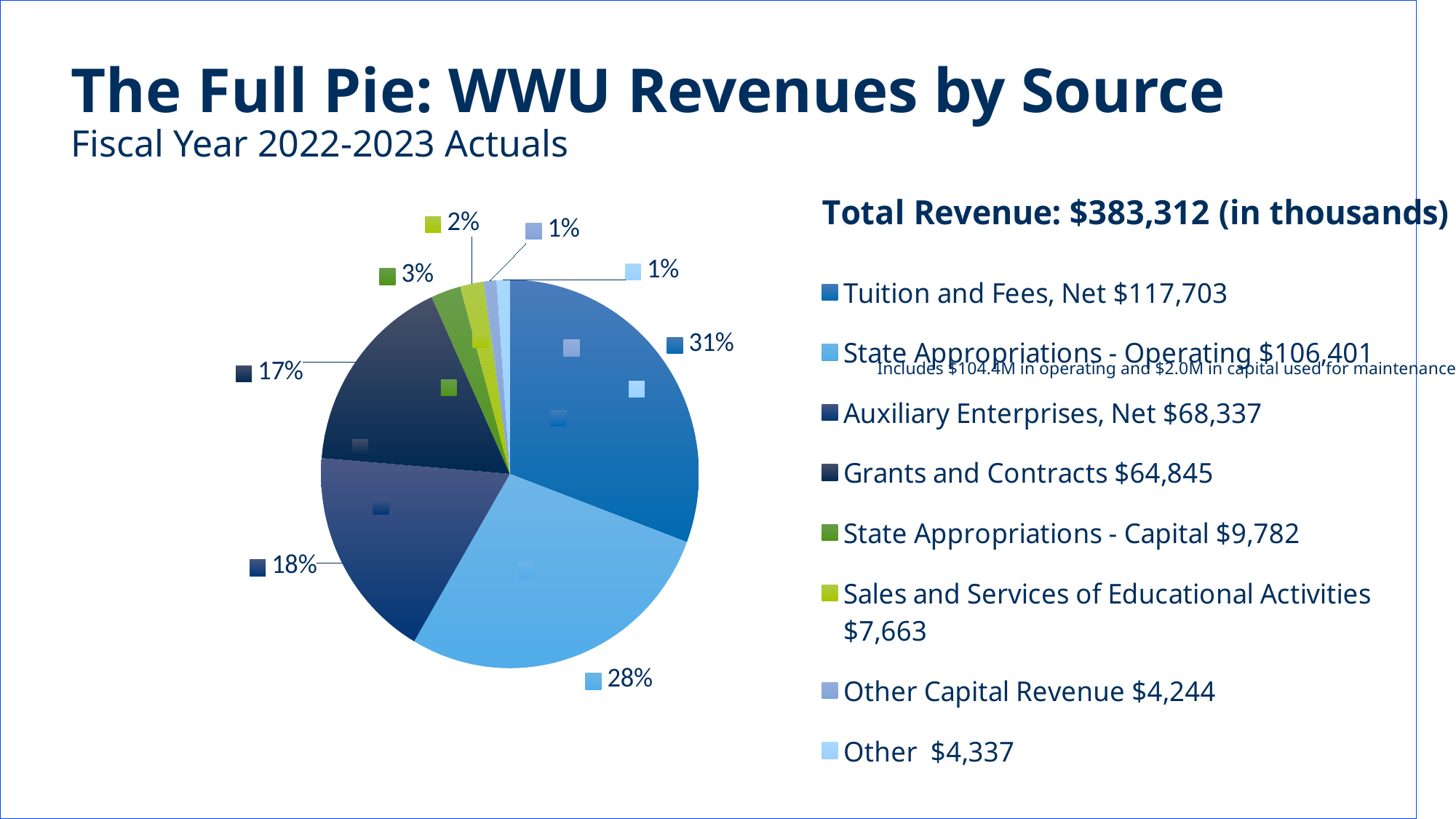
What share of the pie does Tuition and Fees, Net represent? 31% Which is larger, Auxiliary Enterprises, Net or Grants and Contracts? Auxiliary Enterprises, Net What is the revenue value listed for Grants and Contracts? $64,845 Which revenue source has the smallest dollar value listed in the legend? Other Capital Revenue What is the difference between the Tuition and Fees, Net value and the State Appropriations - Operating value? $11,302 What share of the pie does Grants and Contracts represent? 17% What share of the pie does State Appropriations - Operating represent? 28% What kind of chart is shown on the slide? pie chart How many revenue sources (slices) does the pie chart show? 8 Which revenue source is the largest slice of the pie? Tuition and Fees, Net What total revenue figure is stated on the slide? $383,312 (in thousands)